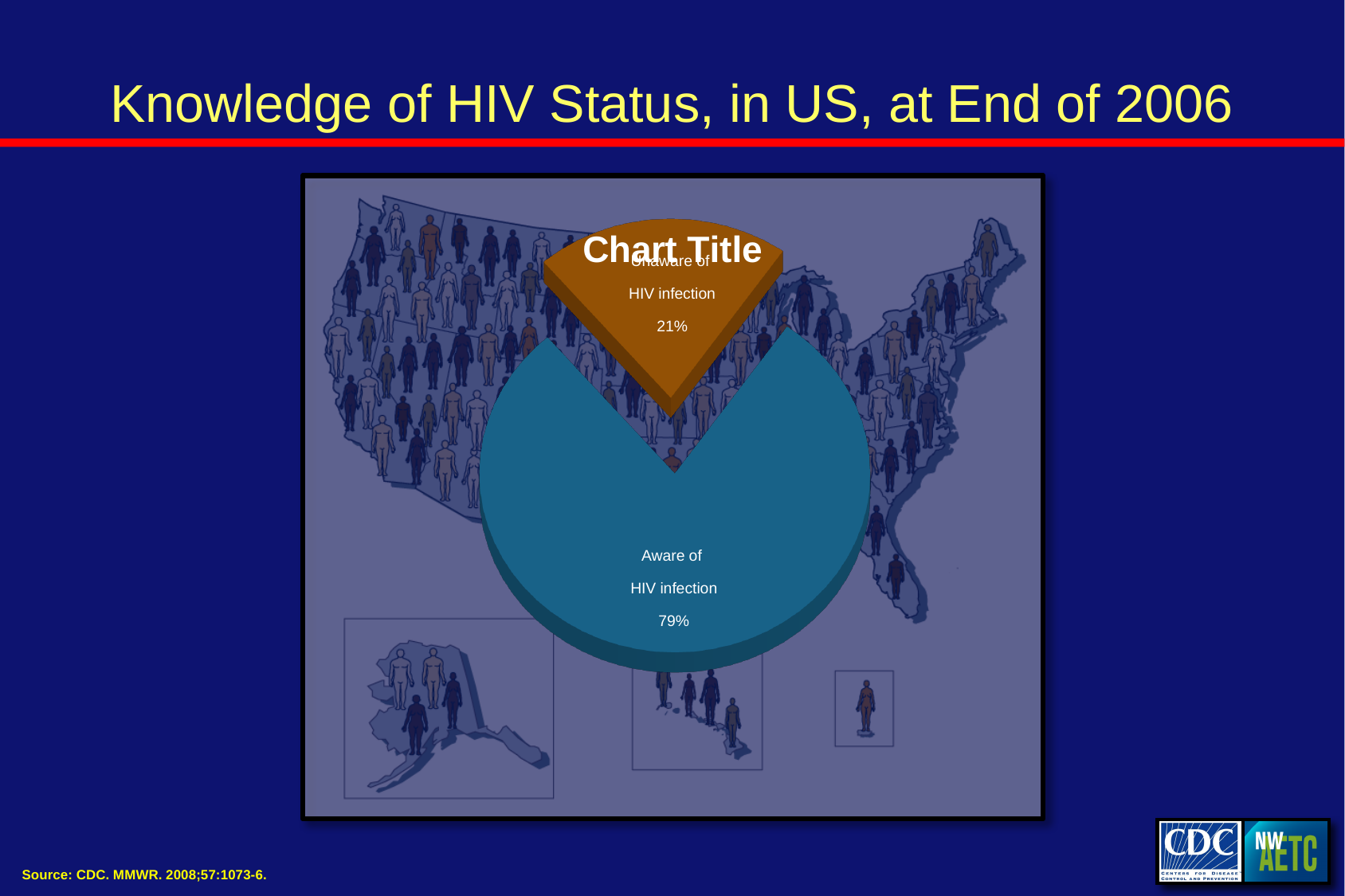
What percentage of the pie is labelled "Unaware of HIV infection"? 21% Which slice of the pie is the smallest? Unaware of HIV infection What is the title printed on the chart itself? Chart Title What is the difference in percentage points between the "Aware of HIV infection" slice and the "Unaware of HIV infection" slice? 58 What share of the pie does the "Unaware of HIV infection" slice represent? 21% Which is larger, the "Aware of HIV infection" slice or the "Unaware of HIV infection" slice? Aware of HIV infection What kind of chart is shown on the slide? pie chart What percentage of the pie is labelled "Aware of HIV infection"? 79% What colour is the "Unaware of HIV infection" slice? brown How many slices does the pie chart have? 2 Which slice of the pie is the largest? Aware of HIV infection